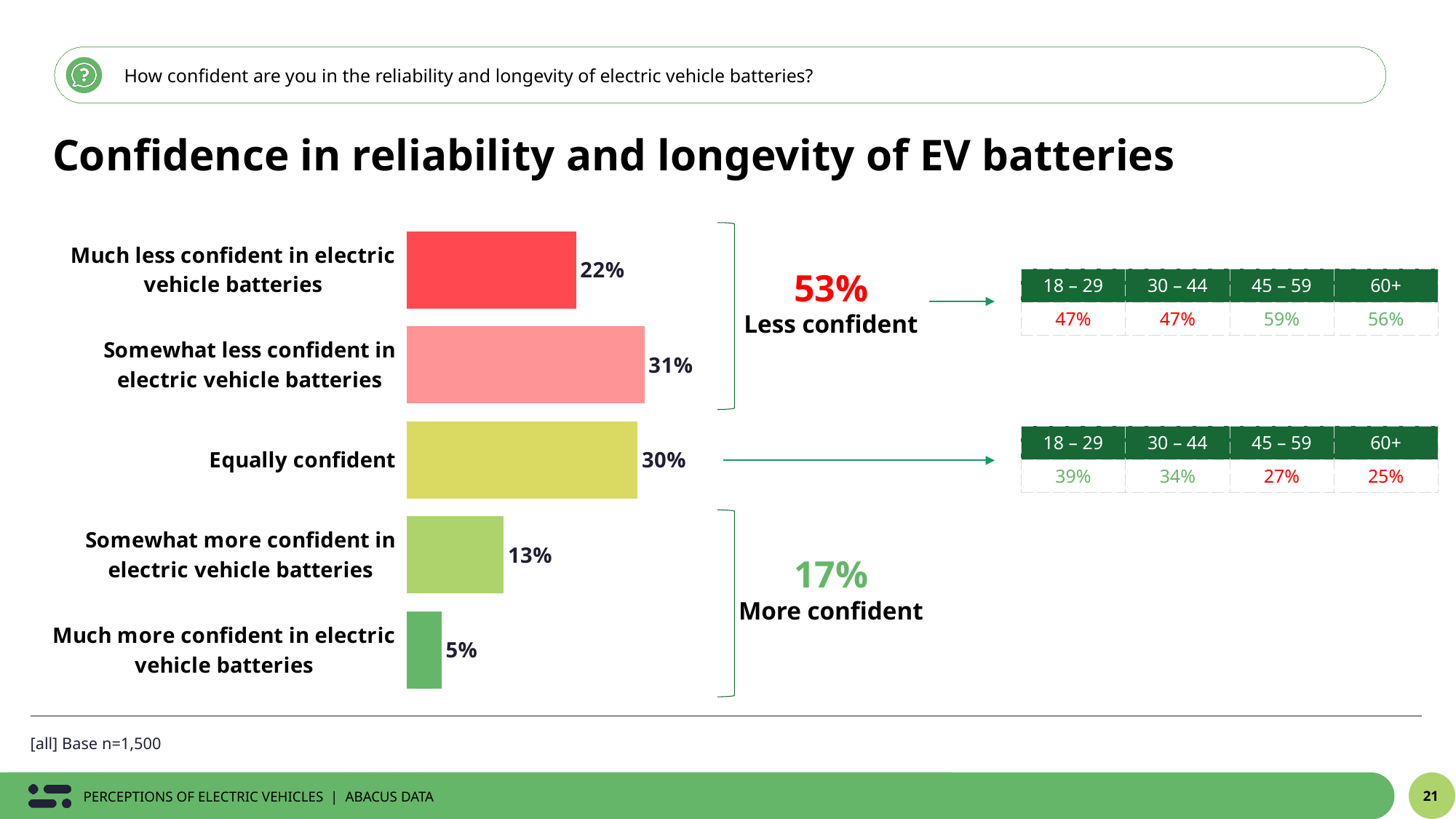
What percentage of respondents are much less confident in electric vehicle batteries? 22% What percentage of respondents are equally confident? 30% What is the difference between the percentage somewhat more confident and the percentage much more confident? 8% How many response categories are shown in the bar chart? 5 What is the combined percentage of respondents who are less confident? 53% What percentage of respondents are somewhat less confident in electric vehicle batteries? 31% Which response category has the lowest percentage? Much more confident in electric vehicle batteries What percentage of respondents are much more confident in electric vehicle batteries? 5% In the age breakdown for 'Less confident', what is the percentage for the 45 – 59 age group? 59% Which is larger: the percentage much less confident or the percentage equally confident? Equally confident Which response category has the highest percentage? Somewhat less confident in electric vehicle batteries What type of chart is used to show the confidence responses? Bar chart